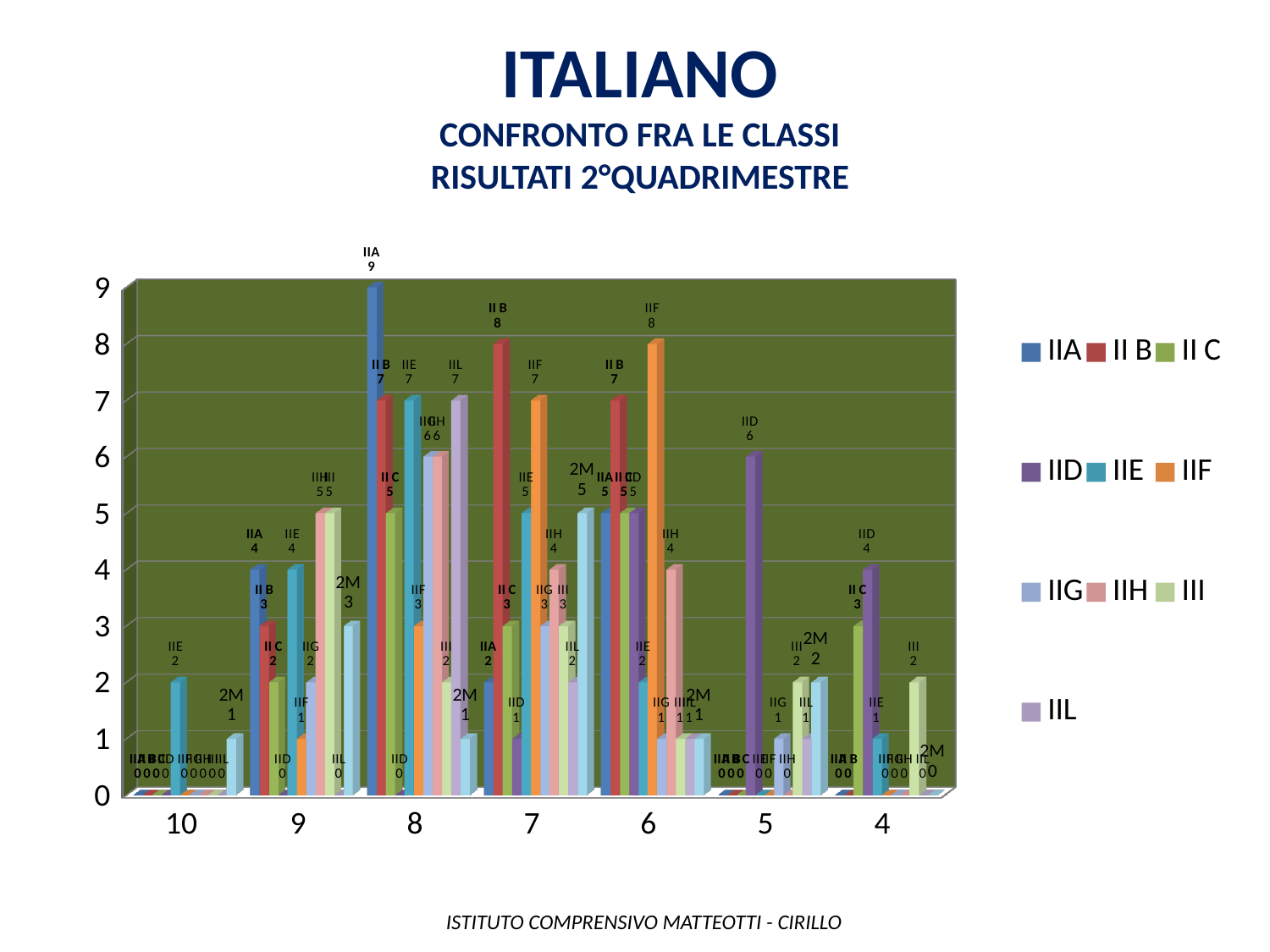
Which is larger at grade 9: IIA or II B? IIA Which class has the highest value at grade 8? IIA What is the value for IIA at grade 8? 9 How many series does the legend list? 10 What kind of chart is shown on the slide? bar chart What is the value for IID at grade 5? 6 What is the value for IIF at grade 6? 8 What is the main title of the chart on the slide? ITALIANO What is the value for II B at grade 7? 8 What is the difference between IIA and II B at grade 8? 2 How many grade categories are shown on the x axis? 7 What is the value for IIE at grade 10? 2